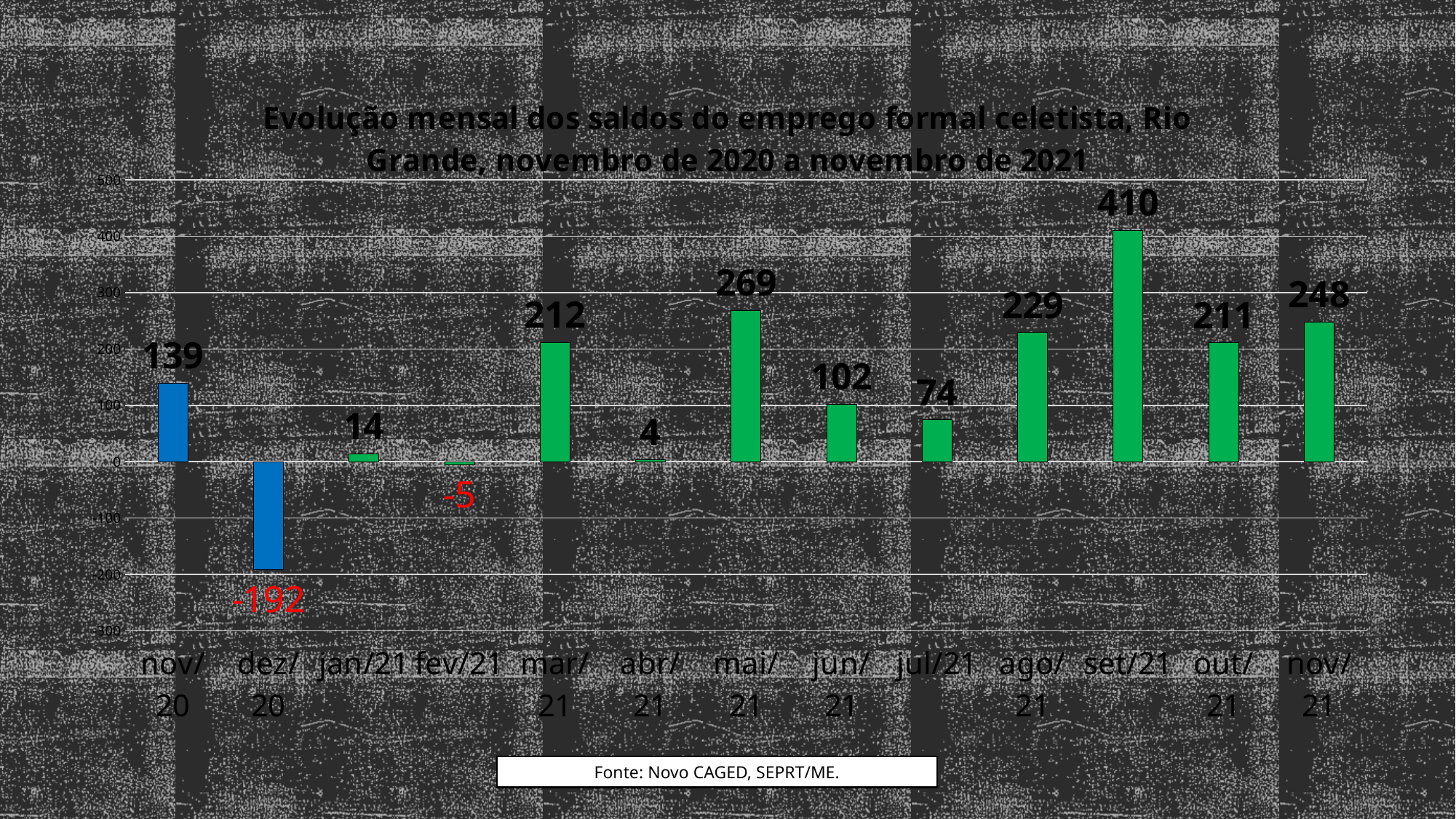
What is the value for fev/21? -5 What is the difference between the values for set/21 and nov/21? 162 Which is larger, the value for mar/21 or the value for out/21? mar/21 What is the value for dez/20? -192 What kind of chart is this? bar chart What source is cited below the chart? Novo CAGED, SEPRT/ME. Which month has the lowest value? dez/20 What is the value for set/21? 410 How many months are shown on the x axis? 13 What is the value for mai/21? 269 Which month has the highest value? set/21 How many months have a negative value? 2